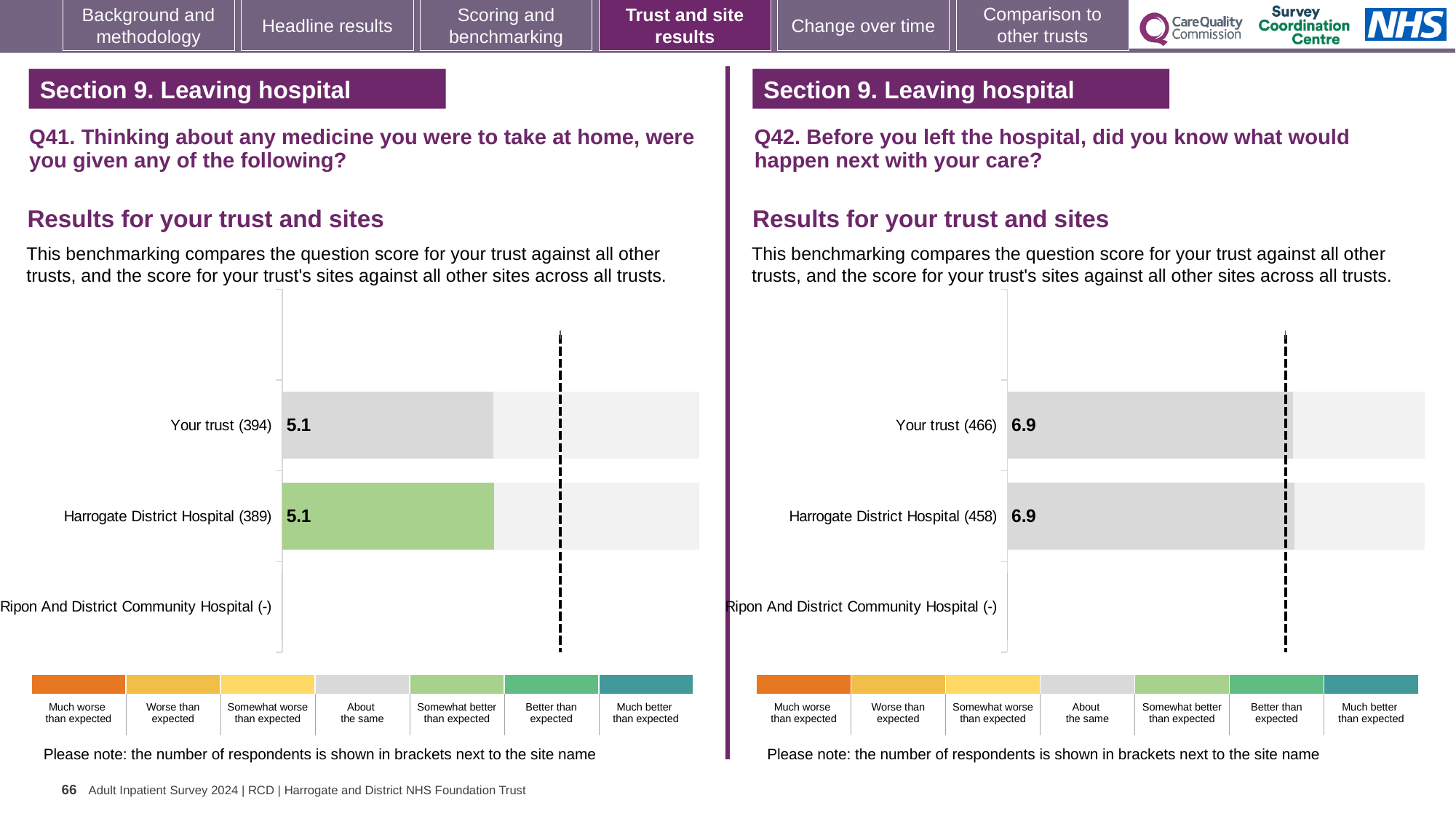
In the Q42 chart on the right, how many respondents are shown in brackets for Harrogate District Hospital? 458 In the Q42 chart on the right, what is the score for Harrogate District Hospital? 6.9 In the Q41 chart on the left, how many respondents are shown in brackets for Your trust? 394 In the Q41 chart on the left, what is the difference between the score for Your trust and the score for Harrogate District Hospital? 0.0 In the Q41 chart on the left, what is the score for Your trust? 5.1 In the Q41 chart on the left, which benchmark category does the green colour of the Harrogate District Hospital bar correspond to in the legend? Somewhat better than expected In the Q42 chart on the right, what is the score for Your trust? 6.9 In the Q42 chart on the right, which benchmark category does the grey colour of the Harrogate District Hospital bar correspond to in the legend? About the same In the Q41 chart on the left, how many categories (rows) are listed on the vertical axis? 3 In the Q41 chart on the left, what is the score for Harrogate District Hospital? 5.1 What kind of chart is the Q42 chart on the right? Bar chart